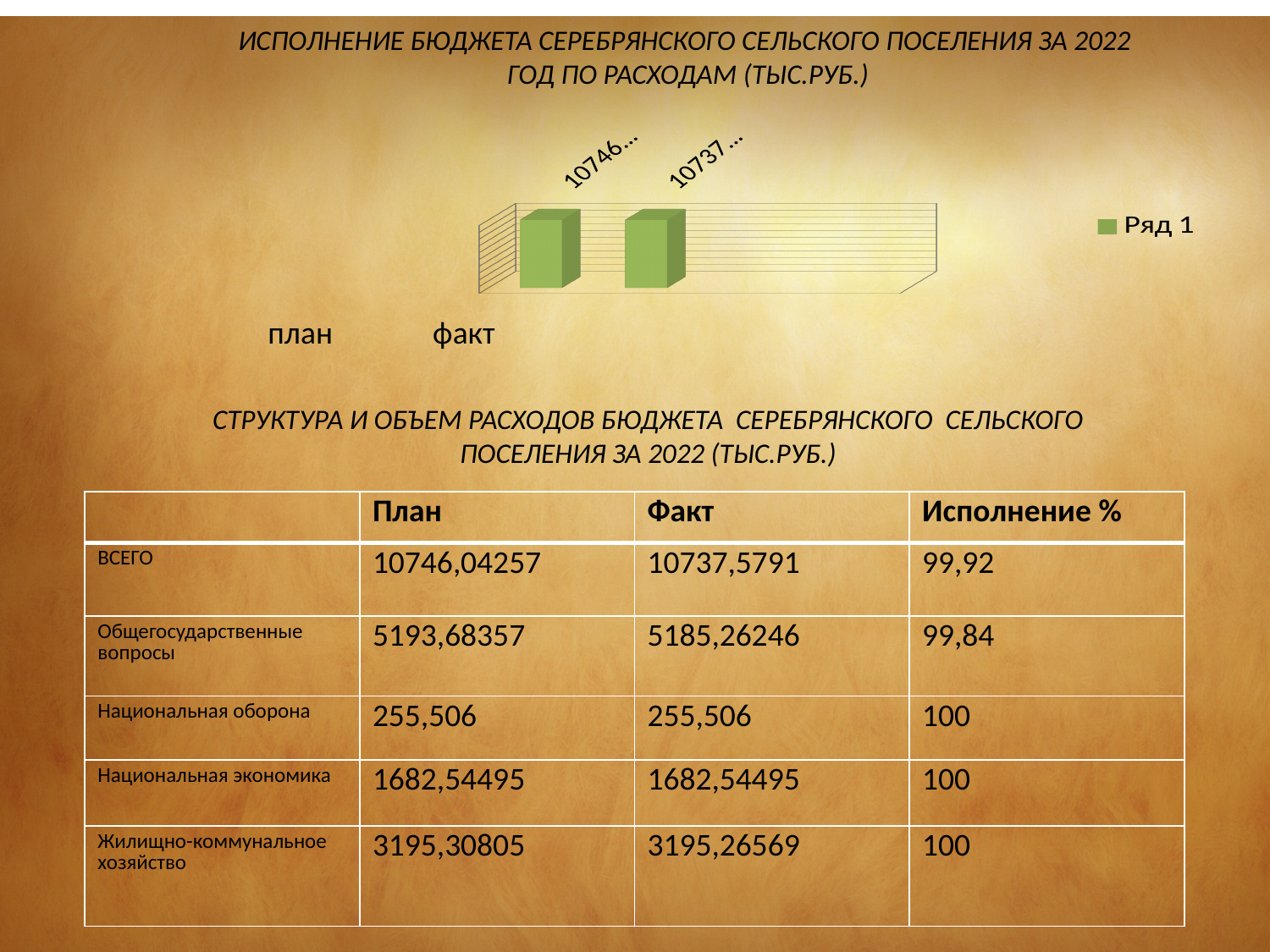
What is the value for план (ВСЕГО) in thousand rubles, as printed on the slide? 10746,04257 What is the title of the chart? ИСПОЛНЕНИЕ БЮДЖЕТА СЕРЕБРЯНСКОГО СЕЛЬСКОГО ПОСЕЛЕНИЯ ЗА 2022 ГОД ПО РАСХОДАМ (ТЫС.РУБ.) What is the name of the series shown in the chart legend? Ряд 1 How many series does the chart legend list? 1 How many bars (categories) does the chart show? 2 What are the two categories on the x axis of the chart? план, факт What is the difference between the план and факт values (ВСЕГО) in thousand rubles? 8,46347 What kind of chart is shown on the slide? bar chart What is the value for факт (ВСЕГО) in thousand rubles, as printed on the slide? 10737,5791